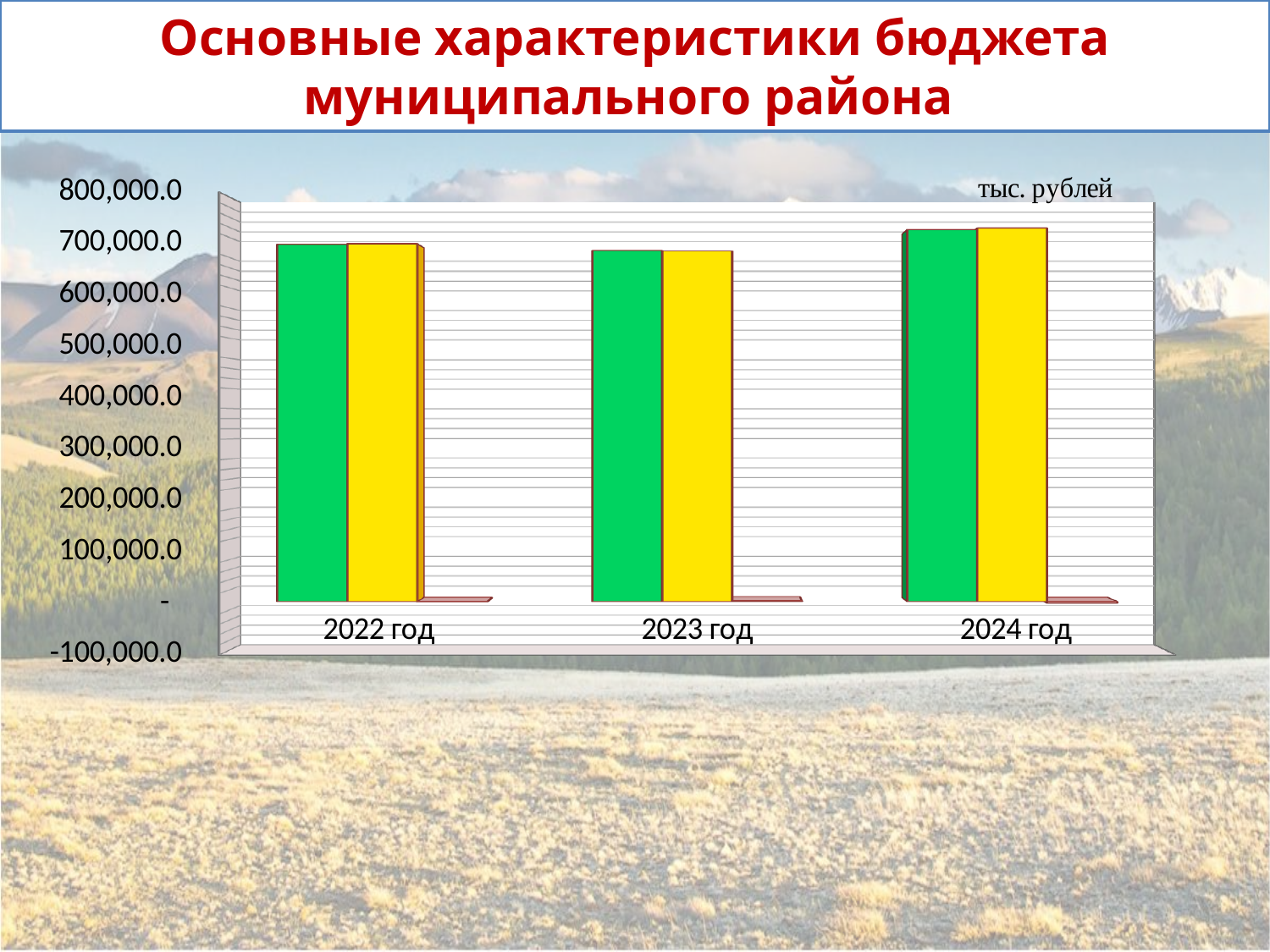
Which is larger: the yellow bar for 2022 год or the yellow bar for 2024 год? 2024 год Is the yellow bar for 2022 год greater or less than 600,000.0? greater How many year categories are shown on the x axis of the chart? 3 What kind of chart is shown on the slide? bar chart What is the lowest value printed on the vertical axis of the chart? -100,000.0 Which year has the tallest yellow bar in the chart? 2024 год Which is larger: the green bar for 2024 год or the green bar for 2023 год? 2024 год Which year has the tallest green bar in the chart? 2024 год Is the green bar for 2023 год greater or less than 500,000.0? greater Is the green bar for 2024 год greater or less than 700,000.0? greater What unit label is printed in the top right corner of the chart? тыс. рублей